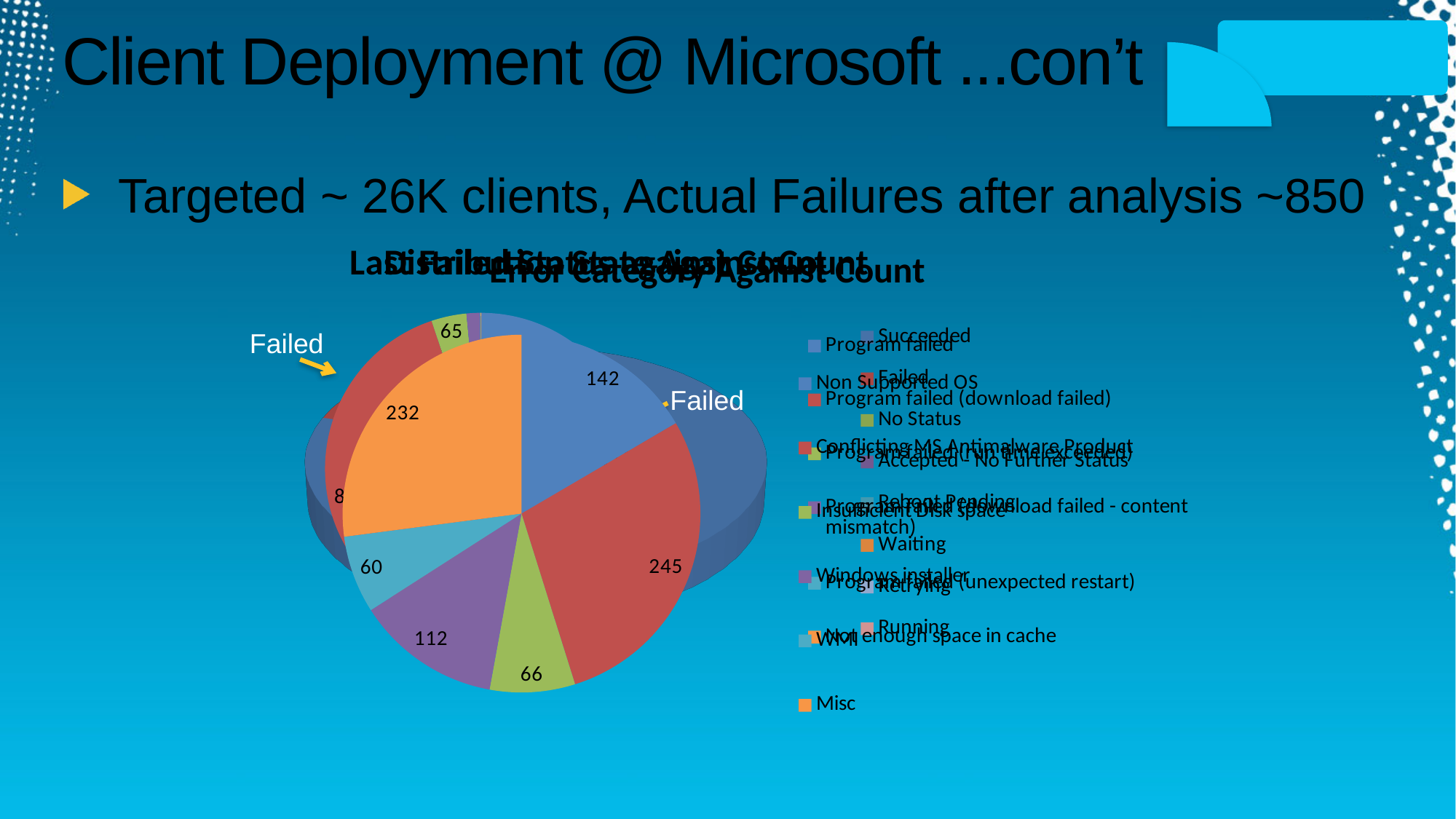
In the Error Category Against Count chart, what is the difference between the slice labelled 245 and the slice labelled 142? 103 What is the title of the front pie chart on the slide? Error Category Against Count In the Error Category Against Count chart, which is larger: the slice labelled 66 or the slice labelled 60? 66 In the Error Category Against Count chart, which is larger: the slice labelled 245 or the slice labelled 142? 245 In the Error Category Against Count chart, what is the largest value shown on a slice? 245 In the Error Category Against Count chart, what is the value of the Misc slice (orange)? 232 In the Error Category Against Count chart, what colour is the Misc legend entry? orange In the Error Category Against Count chart, what kind of chart is used? pie chart In the Error Category Against Count chart, what is the difference between the slice labelled 232 and the slice labelled 112? 120